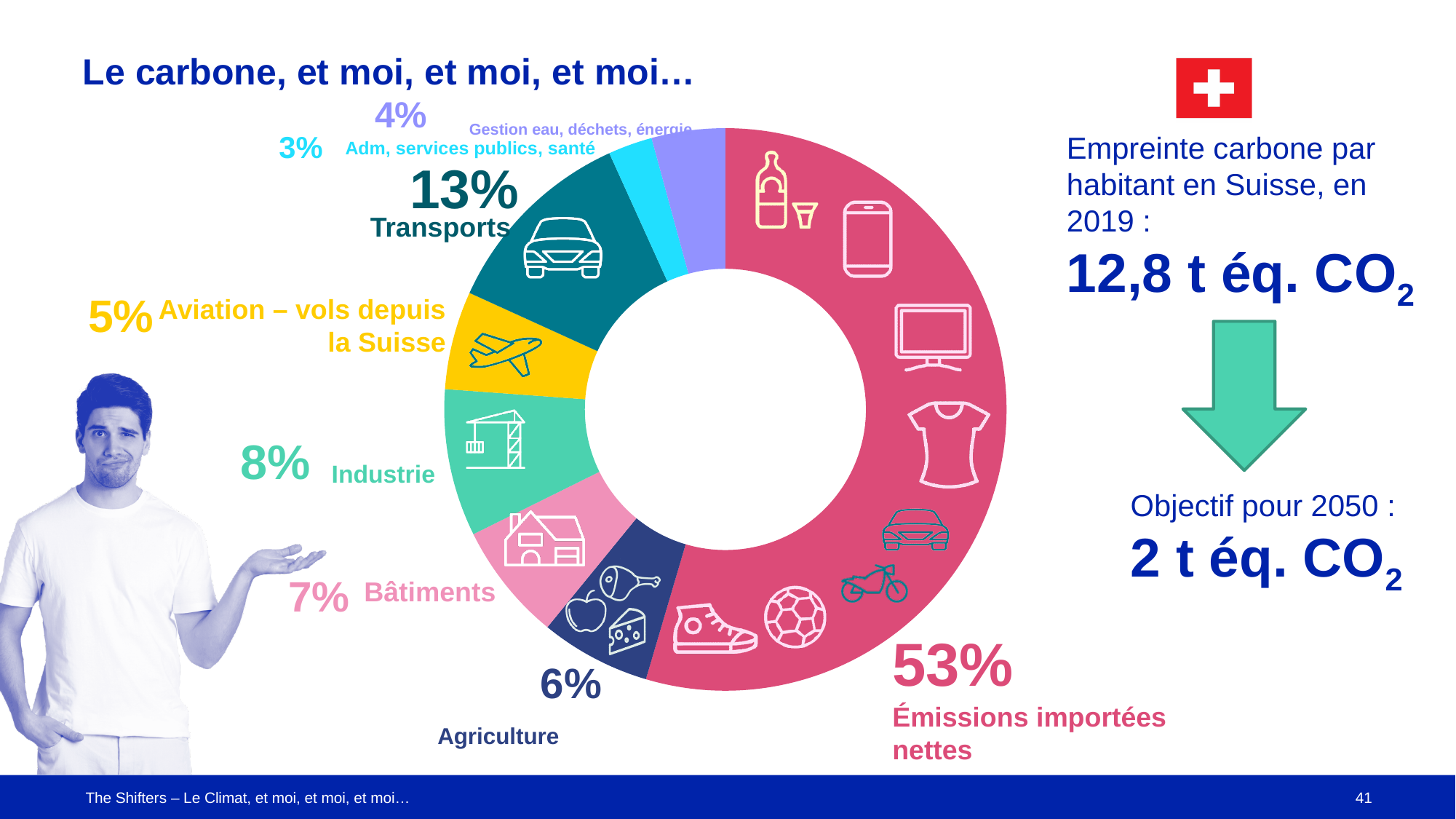
What is the title of the slide containing the chart? Le carbone, et moi, et moi, et moi… What kind of chart is shown on the slide? Pie chart (donut) Which has a larger share, Industrie or Bâtiments? Industrie Which category has the largest share in the pie chart? Émissions importées nettes What percentage does the chart give for Transports? 13% What share of the pie chart is labelled "Émissions importées nettes"? 53% How many categories are shown in the pie chart? 8 What percentage does the chart give for Bâtiments? 7% What is the difference in percentage points between Transports and Industrie? 5 What percentage does the chart give for Agriculture? 6% What percentage does the chart give for "Aviation – vols depuis la Suisse"? 5% Which category has the smallest share in the pie chart? Adm, services publics, santé